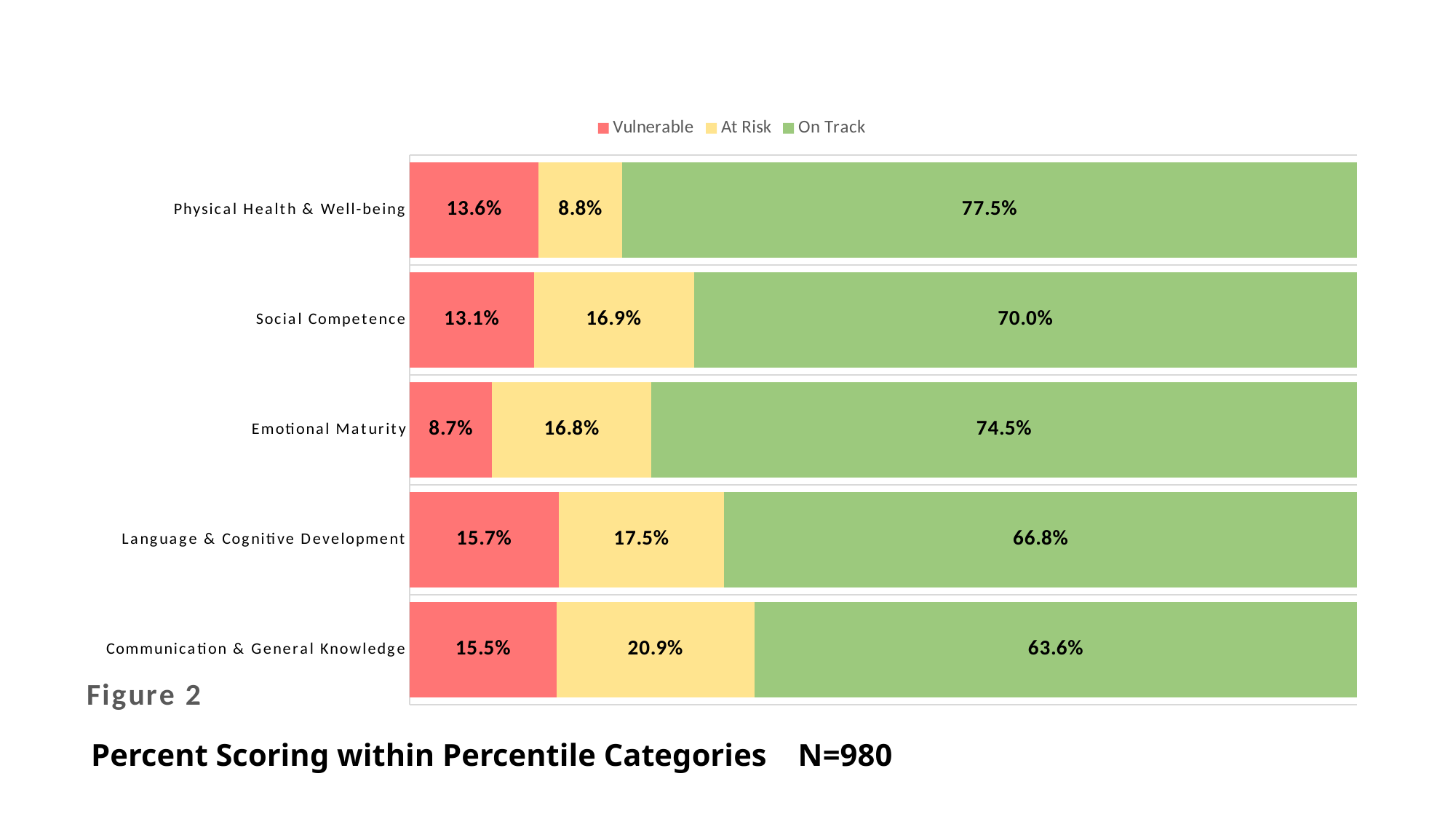
Which domain has the lowest On Track percentage? Communication & General Knowledge What percentage of children are On Track for Physical Health & Well-being? 77.5% How many series does the legend list? 3 What type of chart is shown on the slide? Stacked bar chart Which domain has the highest At Risk percentage? Communication & General Knowledge Which domain has the lowest Vulnerable percentage? Emotional Maturity What is the difference in On Track percentage between Physical Health & Well-being and Communication & General Knowledge? 13.9 percentage points Which domain has the highest On Track percentage? Physical Health & Well-being What is the Vulnerable percentage for Emotional Maturity? 8.7% Is the At Risk percentage higher for Social Competence or for Physical Health & Well-being? Social Competence What is the At Risk percentage for Communication & General Knowledge? 20.9% How many domains are shown in the chart? 5